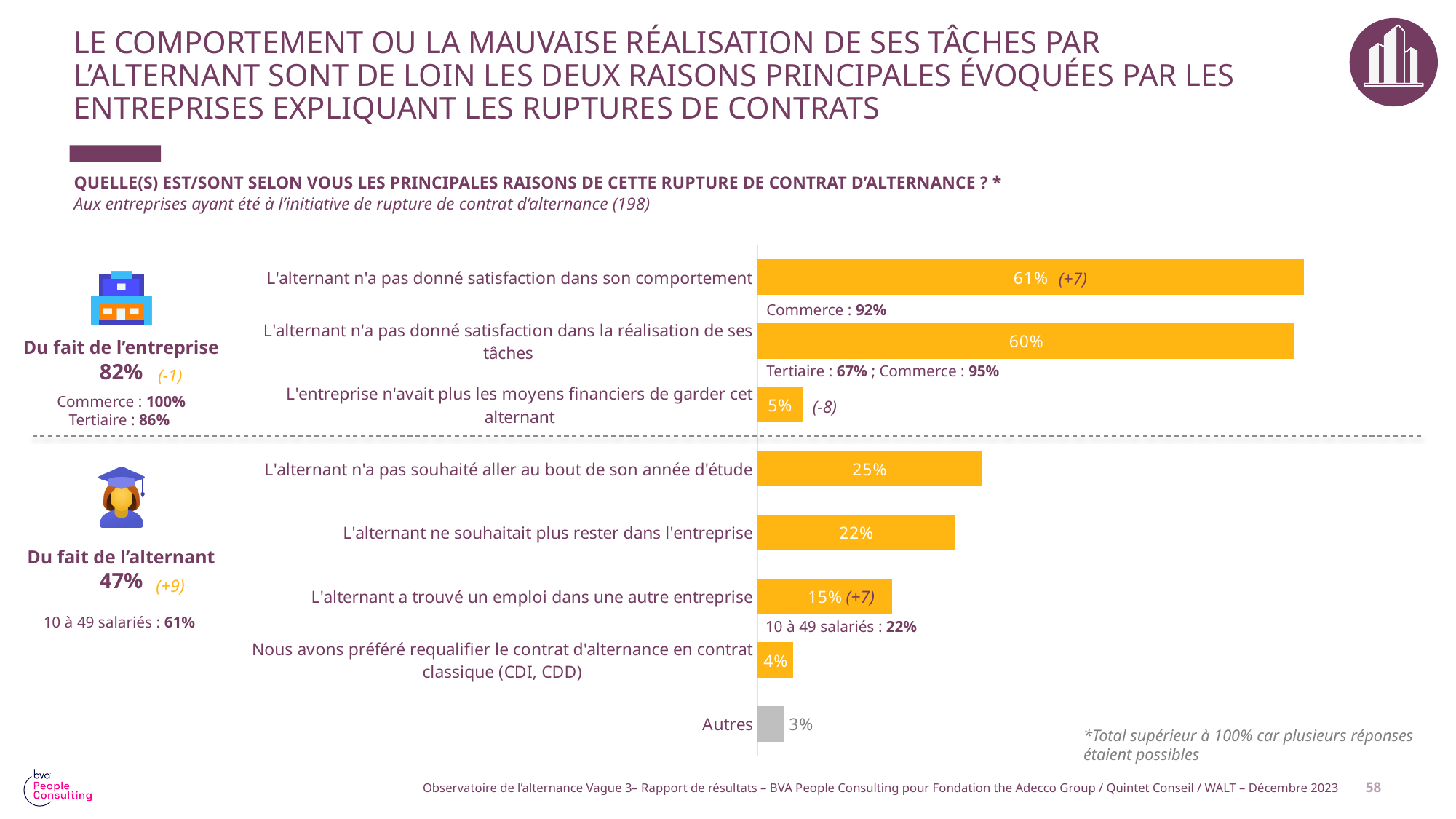
What is the value shown for "L'alternant n'a pas donné satisfaction dans la réalisation de ses tâches"? 60% How many reasons (bars) are shown in the chart? 8 Which is larger: the value for "L'alternant a trouvé un emploi dans une autre entreprise" or the value for "Nous avons préféré requalifier le contrat d'alternance en contrat classique (CDI, CDD)"? L'alternant a trouvé un emploi dans une autre entreprise Which reason has the highest percentage in the chart? L'alternant n'a pas donné satisfaction dans son comportement What value is shown for "L'alternant n'a pas souhaité aller au bout de son année d'étude"? 25% What is the difference between the percentages for "L'alternant n'a pas souhaité aller au bout de son année d'étude" and "L'alternant ne souhaitait plus rester dans l'entreprise"? 3 points What percentage is shown for "Autres"? 3% What percentage is shown for "L'entreprise n'avait plus les moyens financiers de garder cet alternant"? 5% What is the overall percentage shown for "Du fait de l'entreprise"? 82% What type of chart is used on this slide? Bar chart What percentage of companies cited "L'alternant n'a pas donné satisfaction dans son comportement" as a reason for the contract termination? 61% Which reason has the lowest percentage in the chart? Autres